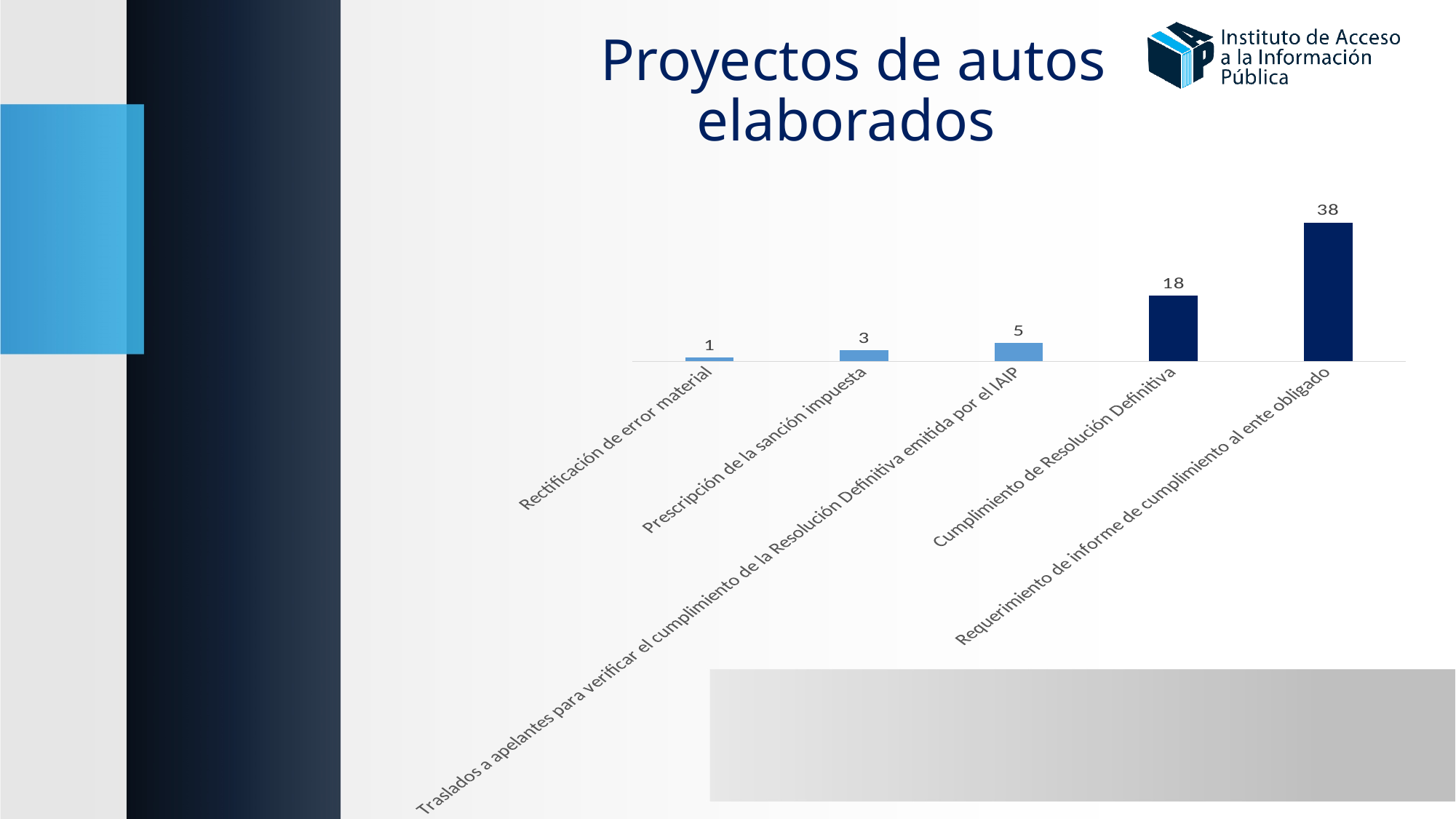
What is the value for Traslados a apelantes para verificar el cumplimiento de la Resolución Definitiva emitida por el IAIP? 5 Do the values rise or fall from left to right along the x axis? Rise What is the value for Requerimiento de informe de cumplimiento al ente obligado? 38 Which category has the lowest value? Rectificación de error material Which is larger: the value for Prescripción de la sanción impuesta or the value for Cumplimiento de Resolución Definitiva? Cumplimiento de Resolución Definitiva What kind of chart is shown on the slide? Bar chart What is the value for Rectificación de error material? 1 Which category has the highest value? Requerimiento de informe de cumplimiento al ente obligado How many categories are shown in the chart? 5 What is the difference between the values for Requerimiento de informe de cumplimiento al ente obligado and Cumplimiento de Resolución Definitiva? 20 What is the value for Prescripción de la sanción impuesta? 3 What is the value for Cumplimiento de Resolución Definitiva? 18